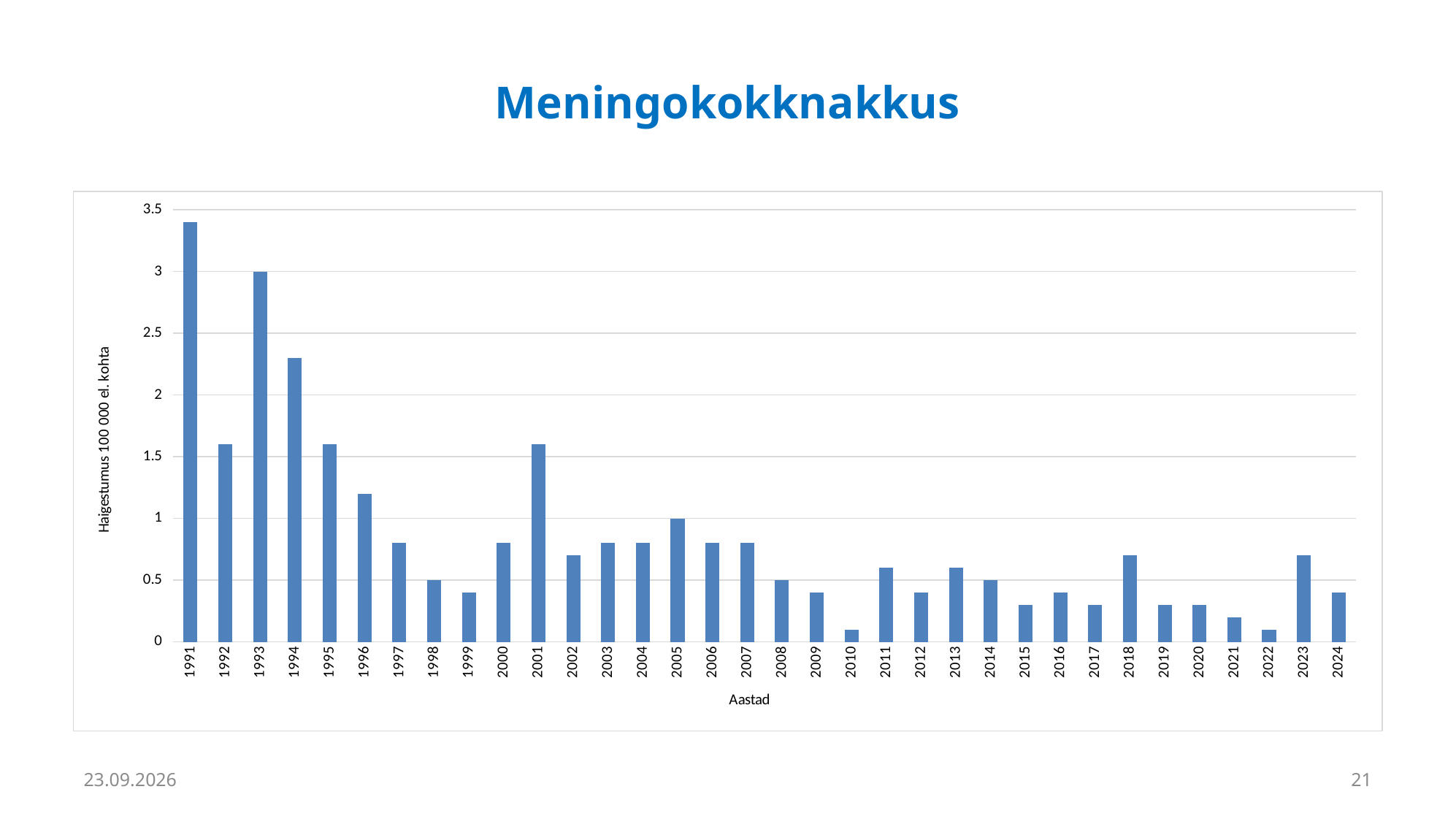
What is the value for 1998? 0.5 Which is larger, the value for 2018 or the value for 2019? 2018 Is the value for 2010 greater or less than 0.5? less What kind of chart is shown on the slide? bar chart Is the value for 1994 greater or less than 2? greater Which is larger, the value for 1993 or the value for 1994? 1993 Is the value for 1996 greater or less than 1? greater What is the label of the y axis? Haigestumus 100 000 el. kohta Which year has the highest value in the chart? 1991 What is the value for 1993? 3 How many years are shown on the x axis? 34